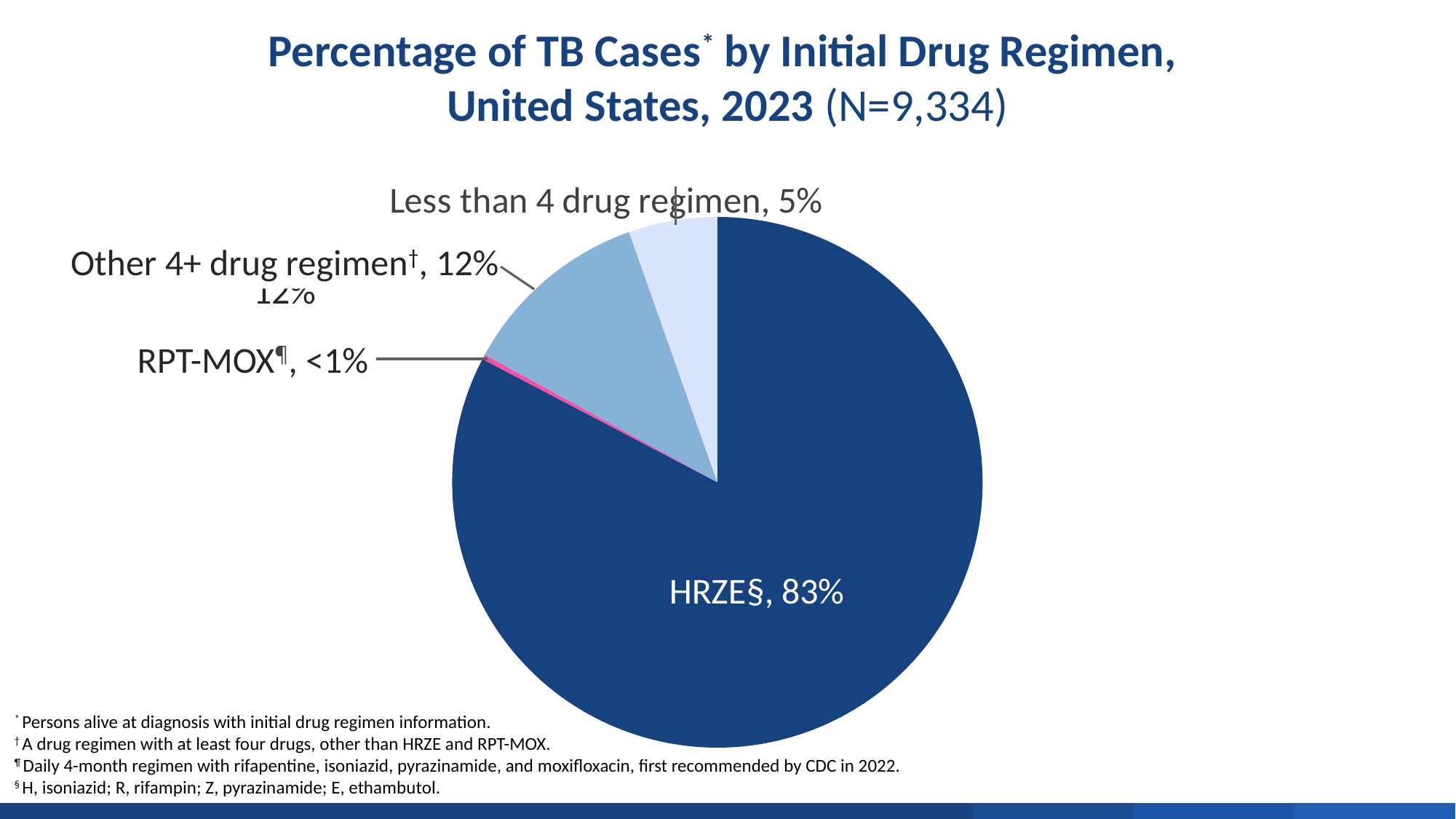
Which is larger: the share for 'Less than 4 drug regimen' or the share for 'Other 4+ drug regimen'? Other 4+ drug regimen How many percentage points higher is the 'Other 4+ drug regimen' share than the 'Less than 4 drug regimen' share? 7 How many slices does the pie chart have? 4 Which initial drug regimen accounts for the smallest share of TB cases? RPT-MOX How many percentage points higher is the HRZE share than the 'Other 4+ drug regimen' share? 71 What is the total number of TB cases (N) stated in the chart title? 9,334 What kind of chart is shown on the slide? Pie chart What percentage of TB cases had RPT-MOX as the initial drug regimen? <1% What percentage of TB cases had an initial drug regimen of HRZE? 83% What percentage of TB cases had an 'Other 4+ drug regimen' as the initial regimen? 12% Which initial drug regimen accounts for the largest share of TB cases? HRZE What percentage of TB cases had an initial regimen of less than 4 drugs? 5%